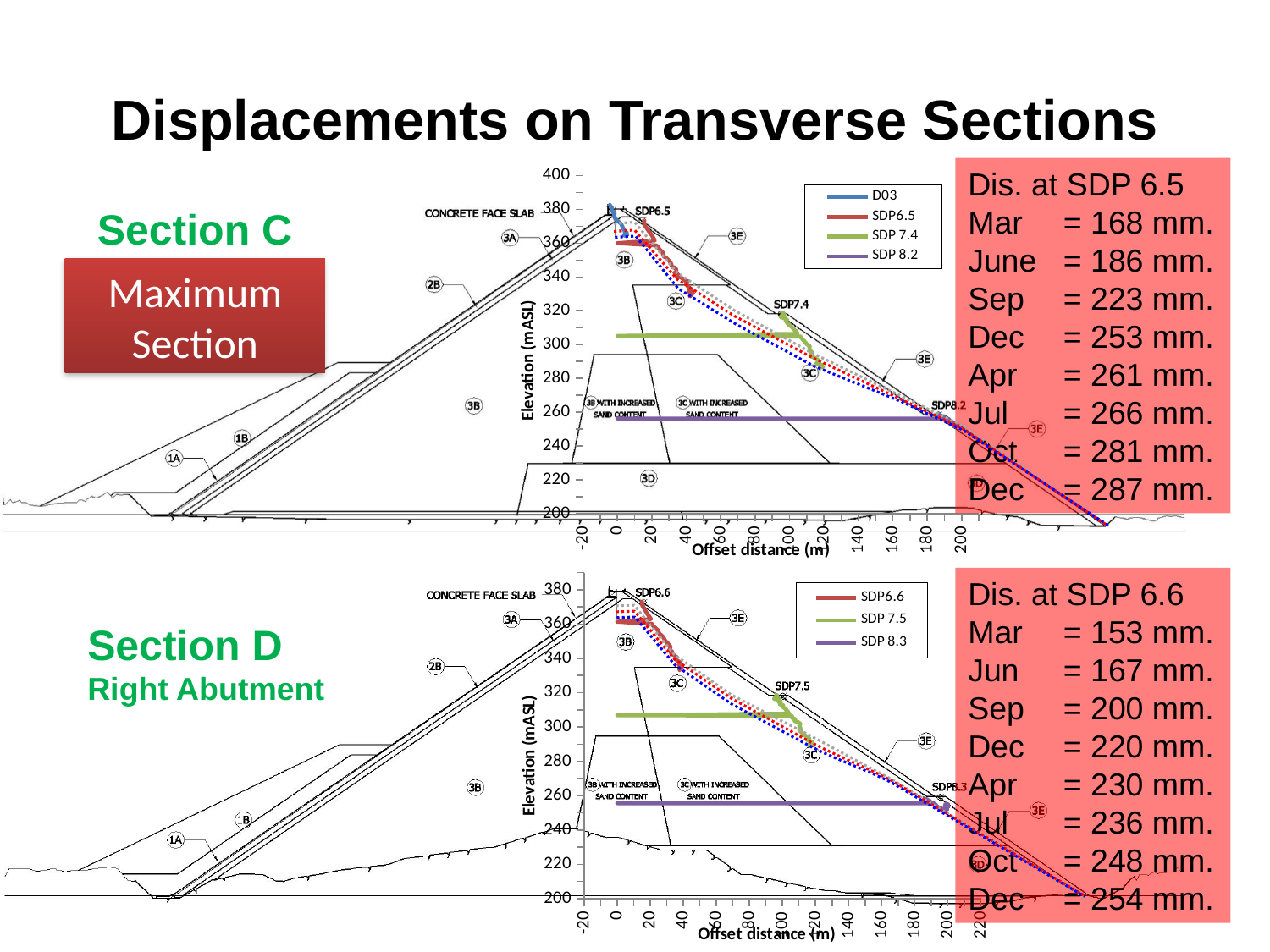
On the Section C chart, which series is plotted at a higher elevation, SDP 7.4 or SDP 8.2? SDP 7.4 On the Section D chart, is the elevation of the SDP 8.3 line greater or less than 280? less On the Section C chart, how many series does the legend list? 4 On the Section D chart, how many series does the legend list? 3 On the Section D chart, is the elevation of the SDP 7.5 line greater or less than 280? greater What kind of chart is the Section C chart? line chart On the Section D chart, which series is plotted at a higher elevation, SDP6.6 or SDP 8.3? SDP6.6 On the Section C chart, is the elevation of the SDP 8.2 line greater or less than 240? greater How many charts are shown on the slide? 2 On the Section D chart, which series is drawn in purple? SDP 8.3 On the Section C chart, what is the label of the vertical axis? Elevation (mASL)